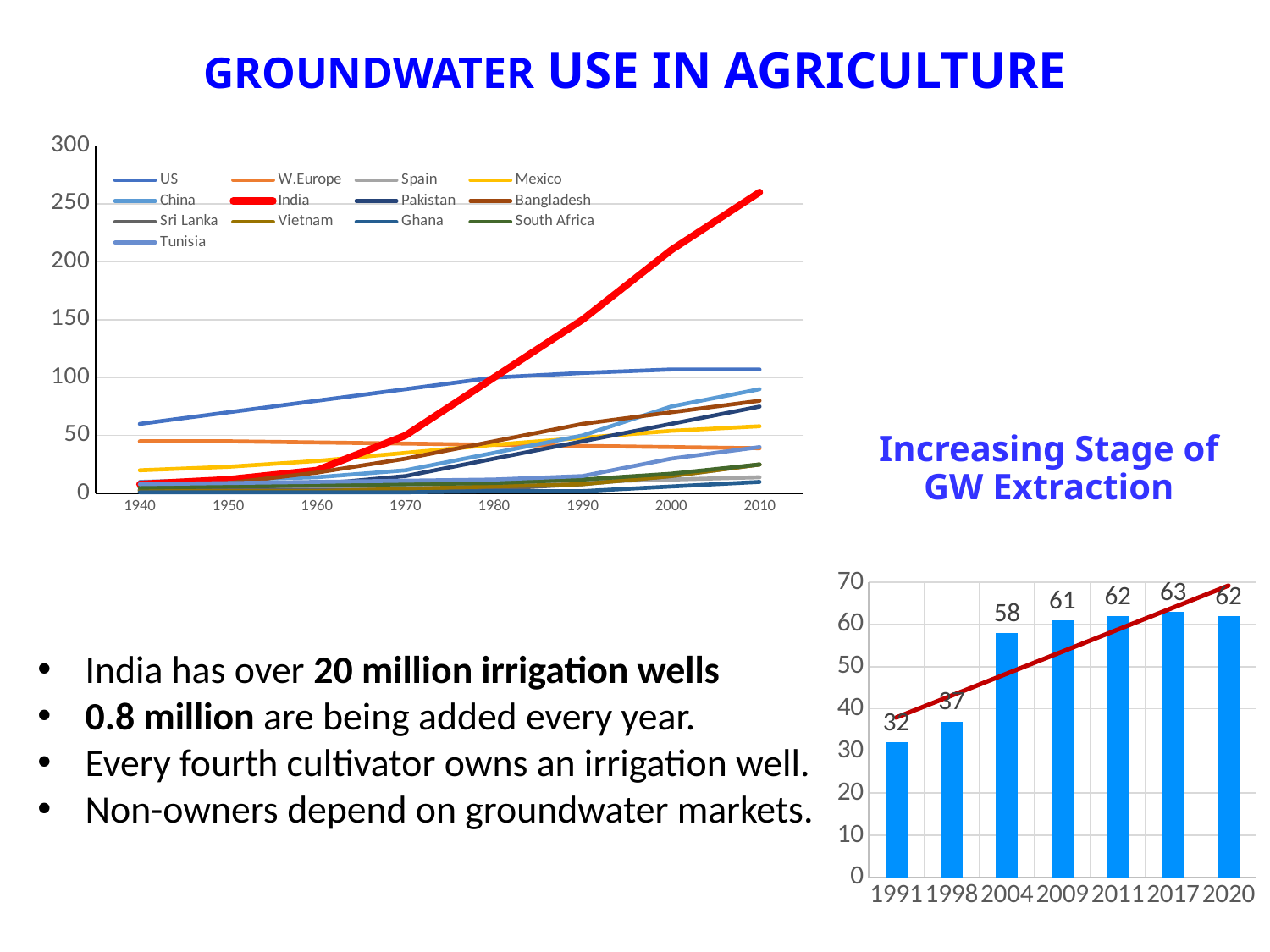
In the top-left line chart, does the India line rise or fall from 1940 to 2010? rise In the top-left line chart, is the value for India in 2010 greater or less than 250? greater In the 'Increasing Stage of GW Extraction' chart, what is the value for 2004? 58 What type of chart is the 'Increasing Stage of GW Extraction' chart? bar chart In the top-left line chart, how many years are marked on the x axis? 8 In the top-left line chart, how many series does the legend list? 13 In the 'Increasing Stage of GW Extraction' chart, which year has the lowest value? 1991 In the 'Increasing Stage of GW Extraction' chart, how many bars are there? 7 In the 'Increasing Stage of GW Extraction' chart, what is the difference between the values for 2020 and 1991? 30 What type of chart is the top-left chart on the slide? line chart In the top-left line chart, which series has the highest value in 2010? India In the 'Increasing Stage of GW Extraction' chart, which year has the highest value? 2017